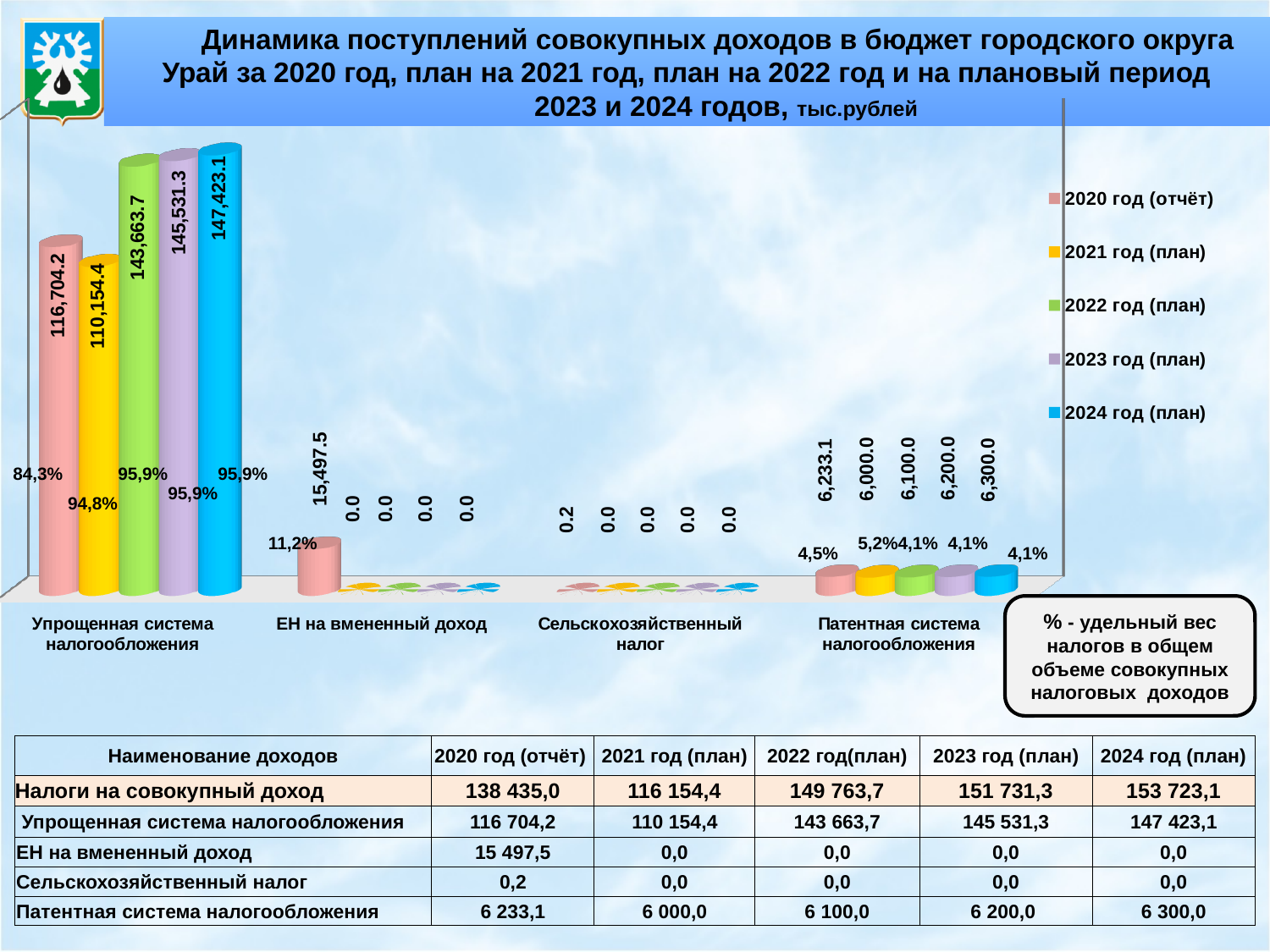
Do the values for Патентная система налогообложения rise or fall from 2021 год (план) to 2024 год (план)? rise What is the value for Упрощенная система налогообложения in the 2024 год (план) series? 147,423.1 What type of chart is shown on the slide? bar chart How many series does the chart legend list? 5 What is the difference between the 2024 год (план) and 2020 год (отчёт) values for Упрощенная система налогообложения? 30,718.9 How many categories are shown on the x axis of the chart? 4 What is the value for Упрощенная система налогообложения in the 2020 год (отчёт) series? 116,704.2 What is the value for ЕН на вмененный доход in the 2020 год (отчёт) series? 15,497.5 Which category has the lowest value in the 2020 год (отчёт) series? Сельскохозяйственный налог Which category has the highest value in the 2024 год (план) series? Упрощенная система налогообложения What is the value for Патентная система налогообложения in the 2022 год (план) series? 6,100.0 Which is larger for Упрощенная система налогообложения: the 2021 год (план) value or the 2022 год (план) value? 2022 год (план)